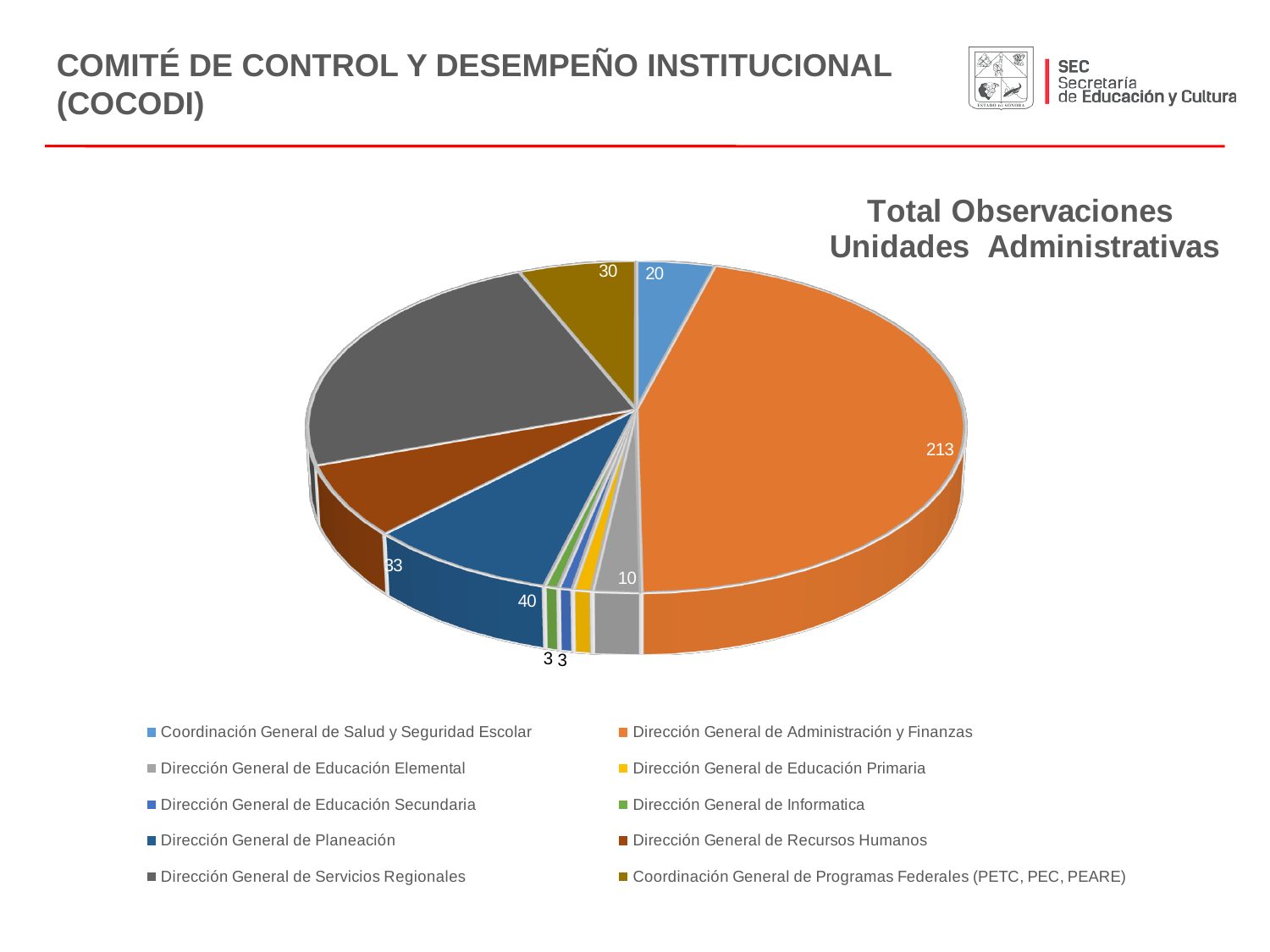
What is the value shown for Dirección General de Planeación? 40 Which unit has the largest slice of the pie? Dirección General de Administración y Finanzas How many entries does the chart legend list? 10 What is the value shown for Coordinación General de Programas Federales (PETC, PEC, PEARE)? 30 What is the difference between the values for Dirección General de Administración y Finanzas and Coordinación General de Salud y Seguridad Escolar? 193 What colour is the slice for Dirección General de Administración y Finanzas? orange What kind of chart is shown on the slide? pie chart What is the value shown for Dirección General de Administración y Finanzas? 213 What is the value shown for Coordinación General de Salud y Seguridad Escolar? 20 Which is larger, the value for Dirección General de Planeación or for Dirección General de Recursos Humanos? Dirección General de Planeación What is the value shown for Dirección General de Educación Elemental? 10 What is the title of the chart? Total Observaciones Unidades Administrativas